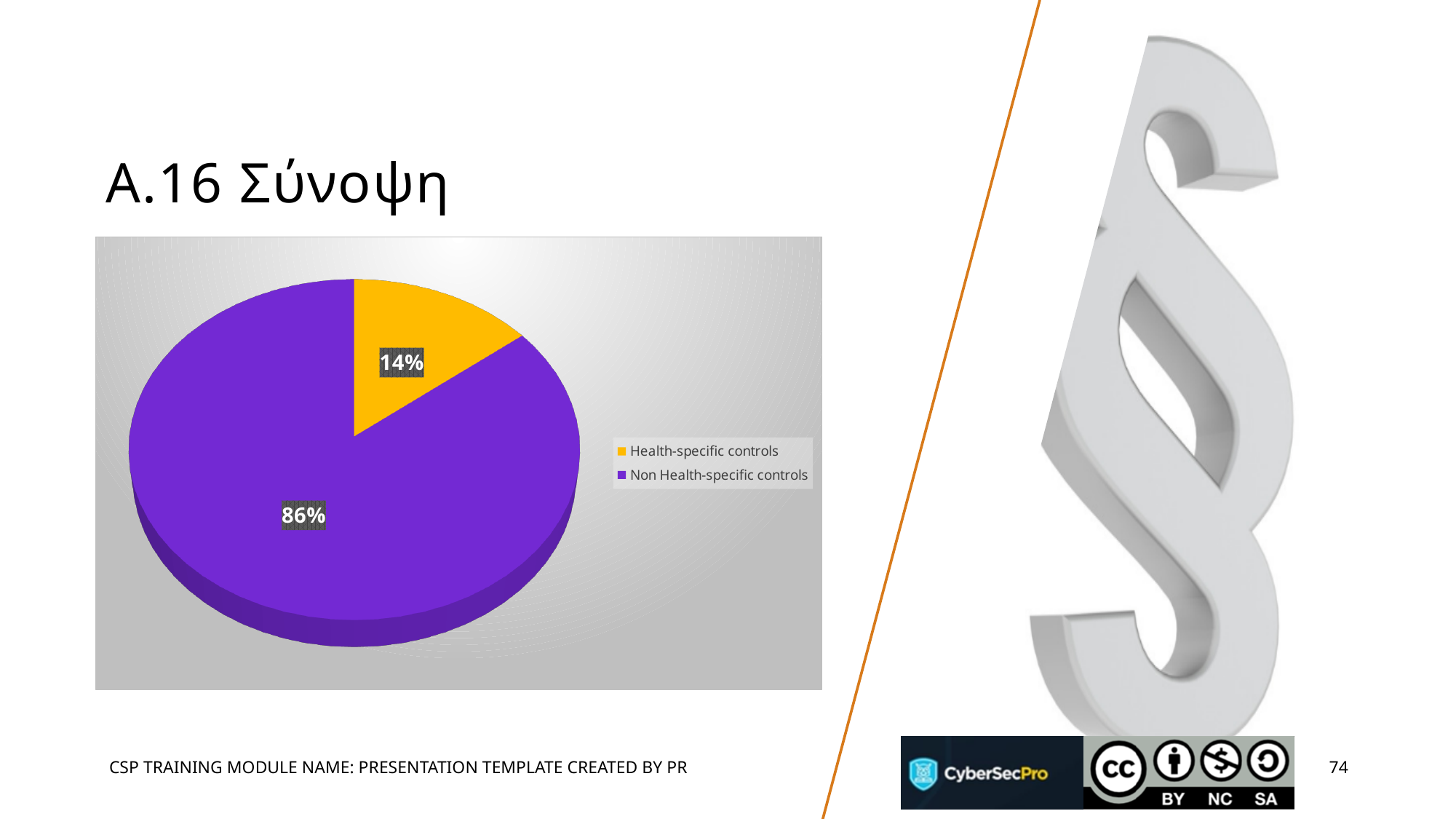
What is the difference in percentage points between Non Health-specific controls and Health-specific controls? 72 What is the total of the two percentages shown on the pie chart? 100% What percentage of the pie is Non Health-specific controls? 86% Which is larger: the share for Health-specific controls or the share for Non Health-specific controls? Non Health-specific controls What colour is the slice for Non Health-specific controls? purple What percentage of the pie is Health-specific controls? 14% Which category has the smallest share of the pie? Health-specific controls Which category has the largest share of the pie? Non Health-specific controls How many entries does the legend list? 2 What kind of chart is shown on the slide? pie chart What colour is the slice for Health-specific controls? yellow How many slices does the pie chart have? 2